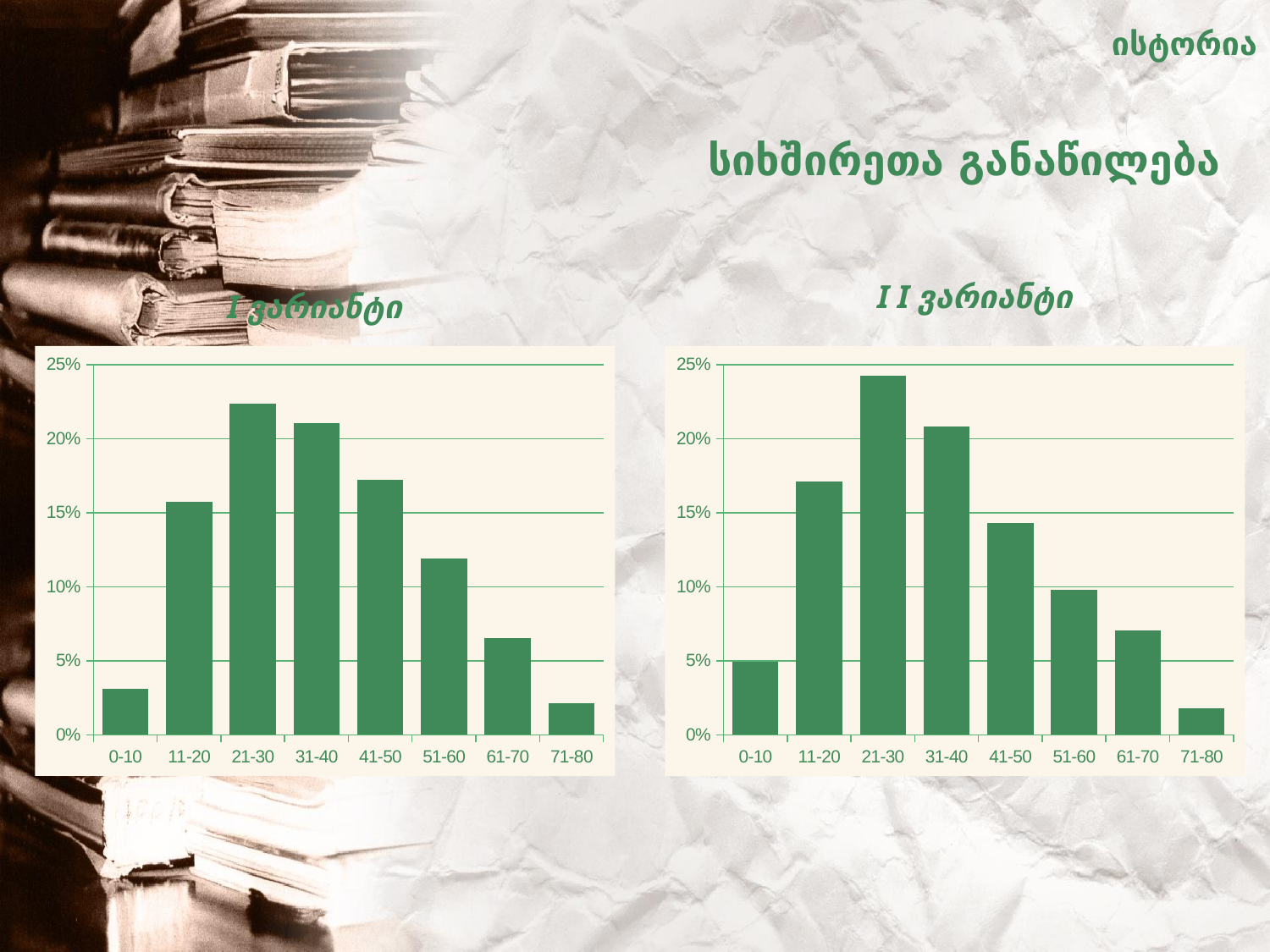
In the left chart (I ვარიანტი), which is larger, the value for 11-20 or the value for 51-60? 11-20 In the right chart (II ვარიანტი), which is larger, the value for 31-40 or the value for 41-50? 31-40 In the right chart (II ვარიანტი), which category has the highest value? 21-30 How many categories are shown on the x axis of the right chart titled "II ვარიანტი"? 8 In the left chart (I ვარიანტი), which category has the lowest value? 71-80 What kind of chart is the left chart titled "I ვარიანტი"? bar chart What is the title of the chart on the right side of the slide? II ვარიანტი In the right chart (II ვარიანტი), is the value for 21-30 greater or less than 20%? greater In the left chart (I ვარიანტი), is the value for 41-50 greater or less than 15%? greater In the right chart (II ვარიანტი), which category has the lowest value? 71-80 In the left chart (I ვარიანტი), which category has the highest value? 21-30